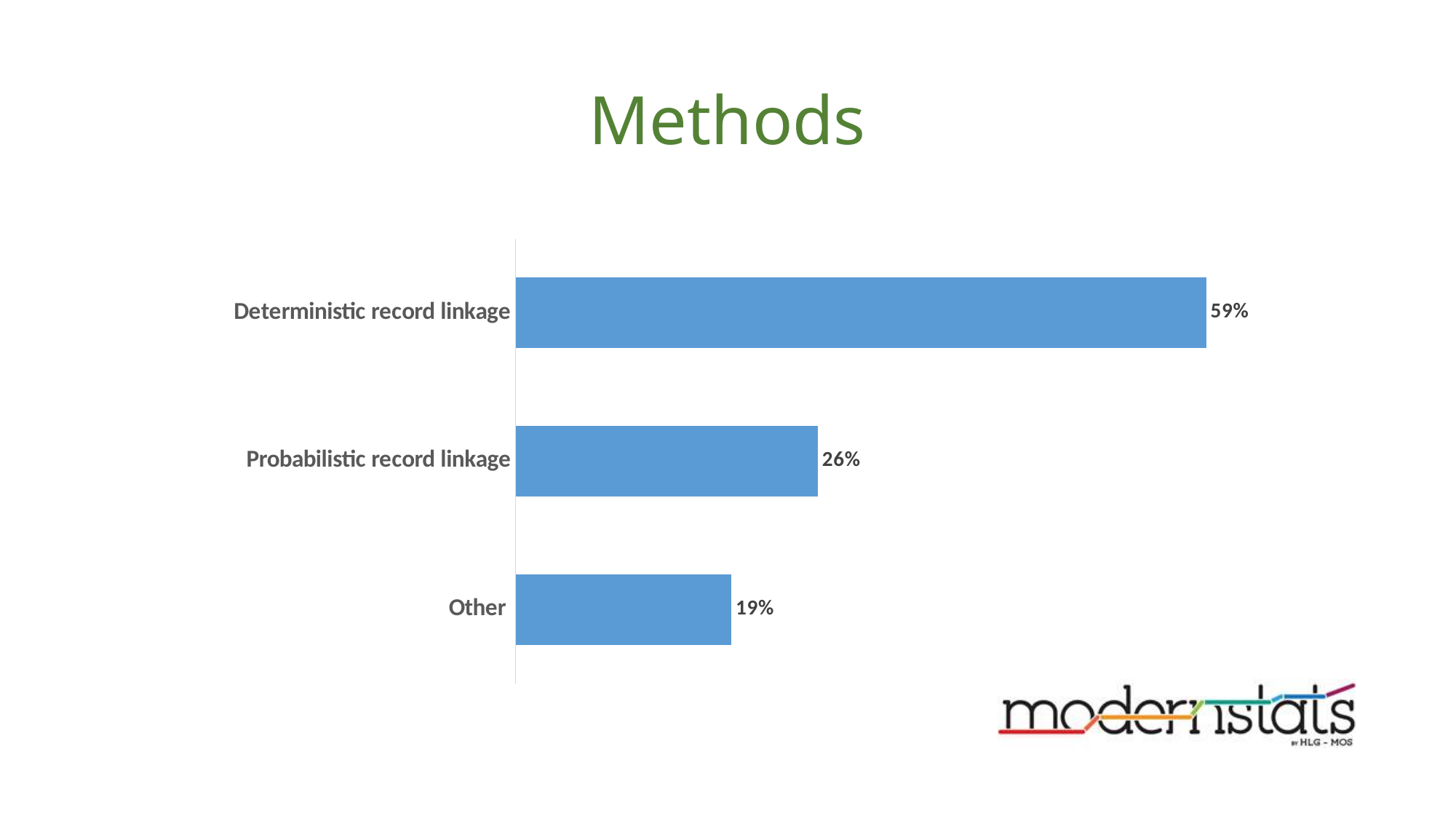
Which method has the highest value? Deterministic record linkage Which is larger, Probabilistic record linkage or Other? Probabilistic record linkage What is the value for Other? 19% Which category has the lowest value? Other How many categories are shown in the chart? 3 What kind of chart is shown on the slide? Bar chart What is the value for Probabilistic record linkage? 26% What is the difference between Probabilistic record linkage and Other? 7% What colour are the bars in the chart? Blue What is the title of the slide? Methods What is the value for Deterministic record linkage? 59% What is the difference between Deterministic record linkage and Probabilistic record linkage? 33%